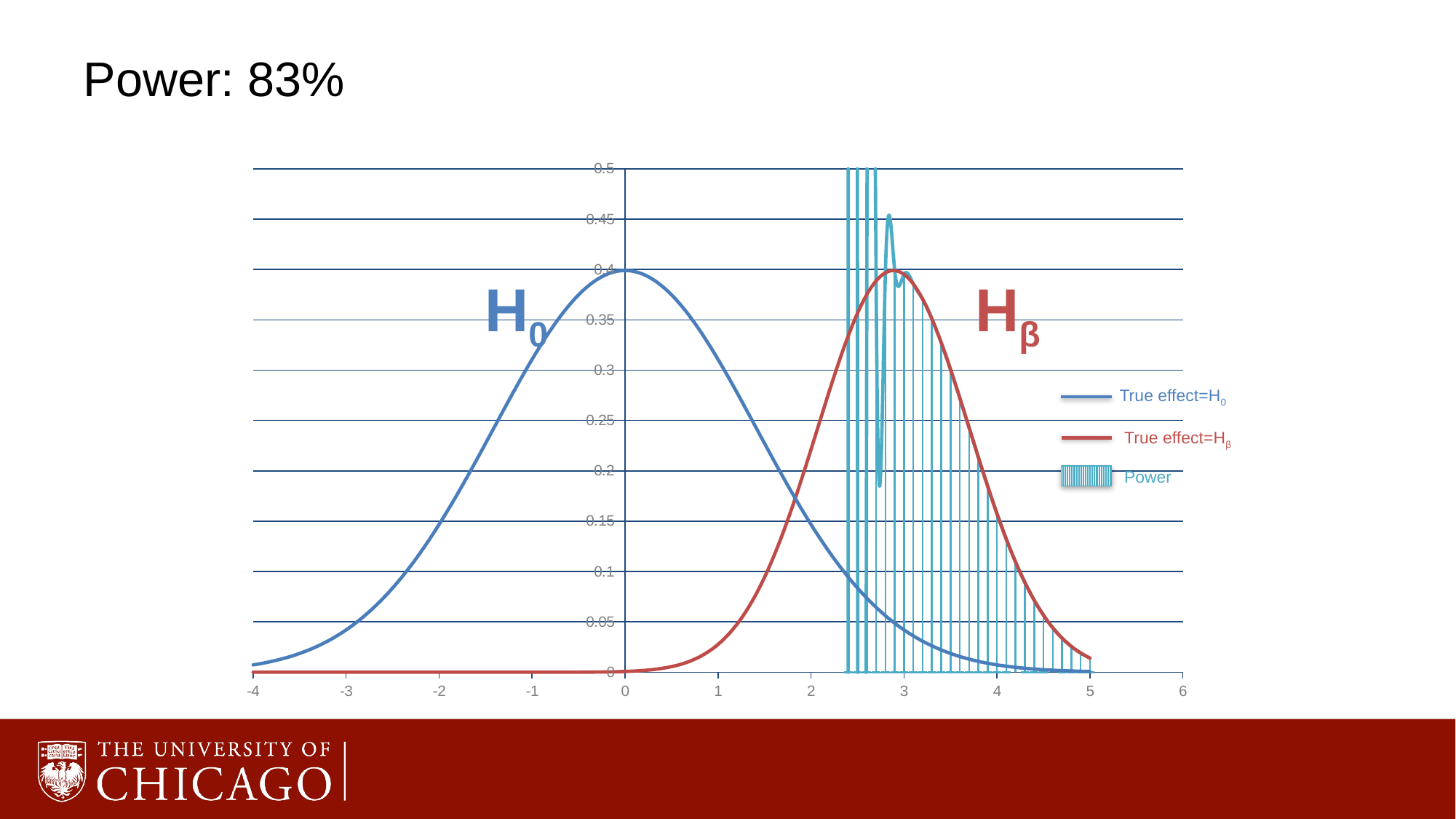
What colour is the line for the series True effect=Hβ? red At which x value does the True effect=H0 curve reach its peak? 0 At x=4, which curve is higher, True effect=H0 or True effect=Hβ? True effect=Hβ Does the True effect=H0 curve rise or fall as x goes from 0 to 4? fall What is the title of the slide above the chart? Power: 83% Is the peak value of the True effect=H0 curve greater or less than 0.3? greater Is the value of the True effect=H0 curve at x=3 greater or less than 0.05? less At x=1, which curve is higher, True effect=H0 or True effect=Hβ? True effect=H0 How many series does the legend list? 3 Is the value of the True effect=Hβ curve at x=0 greater or less than 0.05? less What kind of chart is shown on the slide? line chart